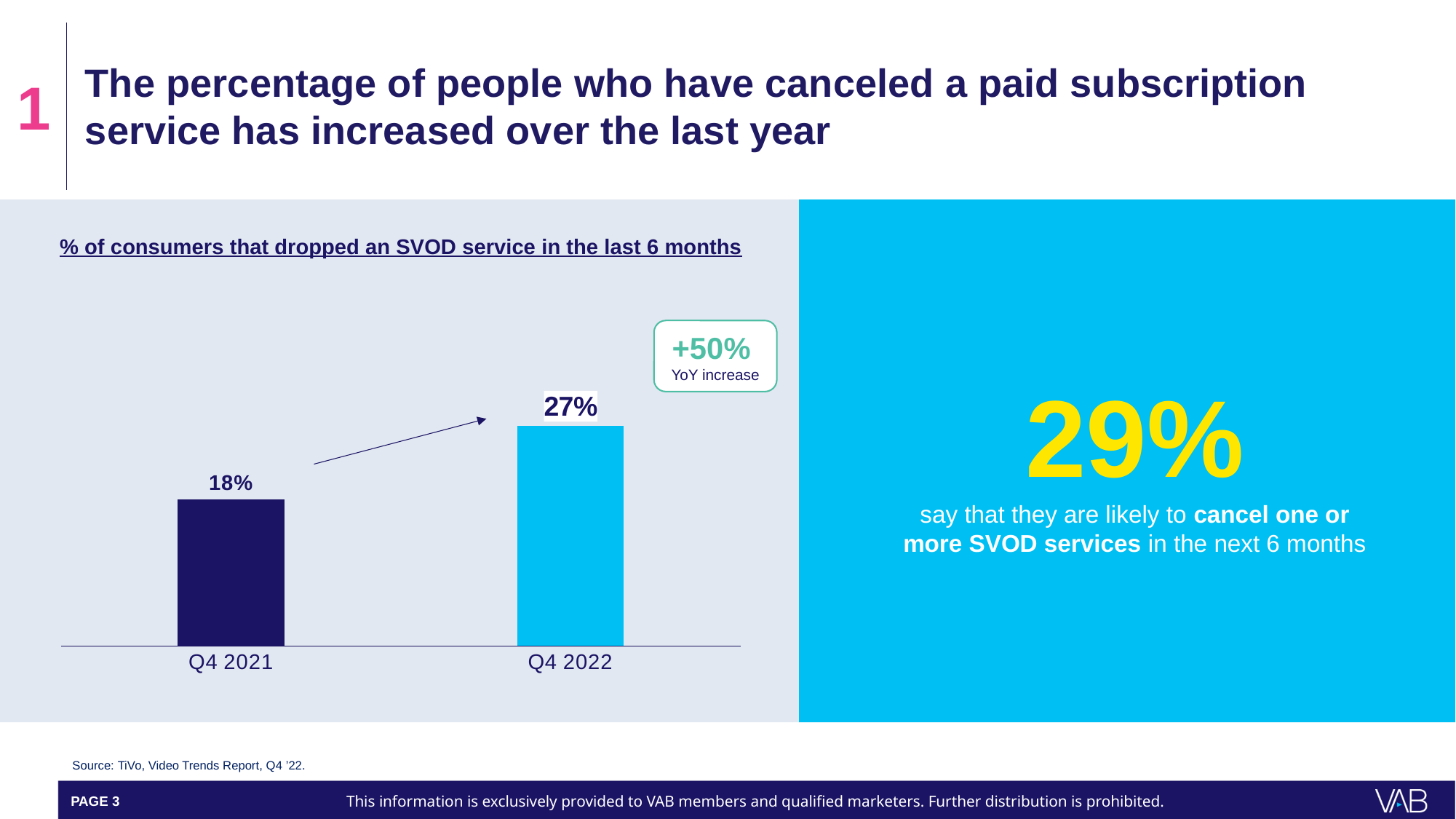
What YoY increase is shown in the callout box on the chart? +50% Which category has the highest value? Q4 2022 What is the title of the chart? % of consumers that dropped an SVOD service in the last 6 months Which is larger, the value for Q4 2021 or Q4 2022? Q4 2022 How many categories are shown on the chart? 2 What is the difference between the Q4 2022 and Q4 2021 values? 9% What kind of chart is shown on the slide? Bar chart What is the value for Q4 2022? 27% What is the value for Q4 2021? 18% Which category has the lowest value? Q4 2021 Do the values rise or fall from Q4 2021 to Q4 2022? Rise